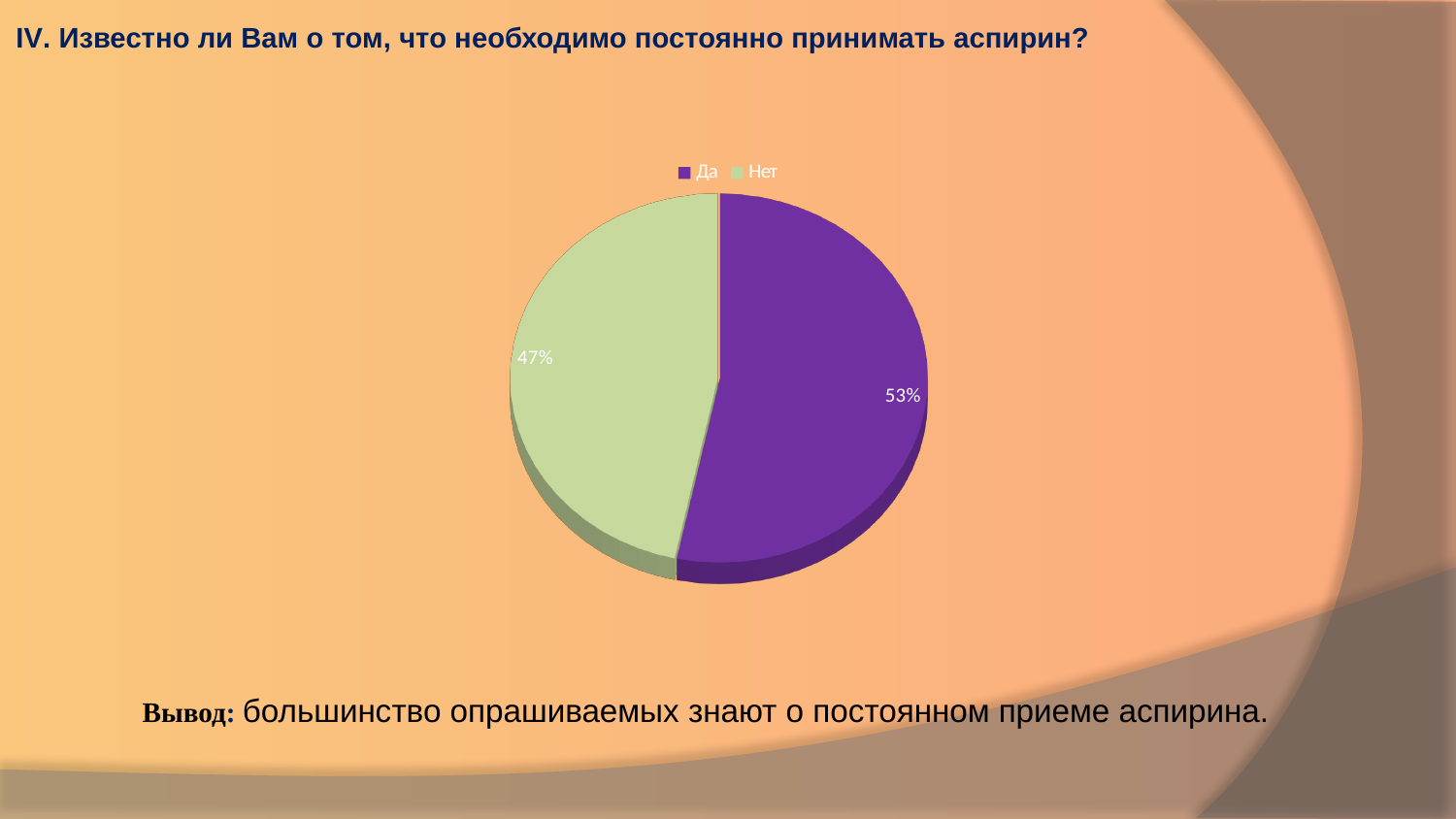
How many entries does the legend list? 2 What percentage of respondents answered "Нет" (No)? 47% What colour is the "Нет" slice? light green What kind of chart is shown on the slide? pie chart What share of the pie does the "Нет" slice represent? 47% Is the share for "Да" larger or smaller than the share for "Нет"? larger What percentage of respondents answered "Да" (Yes)? 53% Which answer has the smaller share of the pie? Нет Which answer has the larger share of the pie? Да What is the difference in percentage points between the "Да" and "Нет" slices? 6 How many slices does the pie chart have? 2 What colour is the "Да" slice? purple